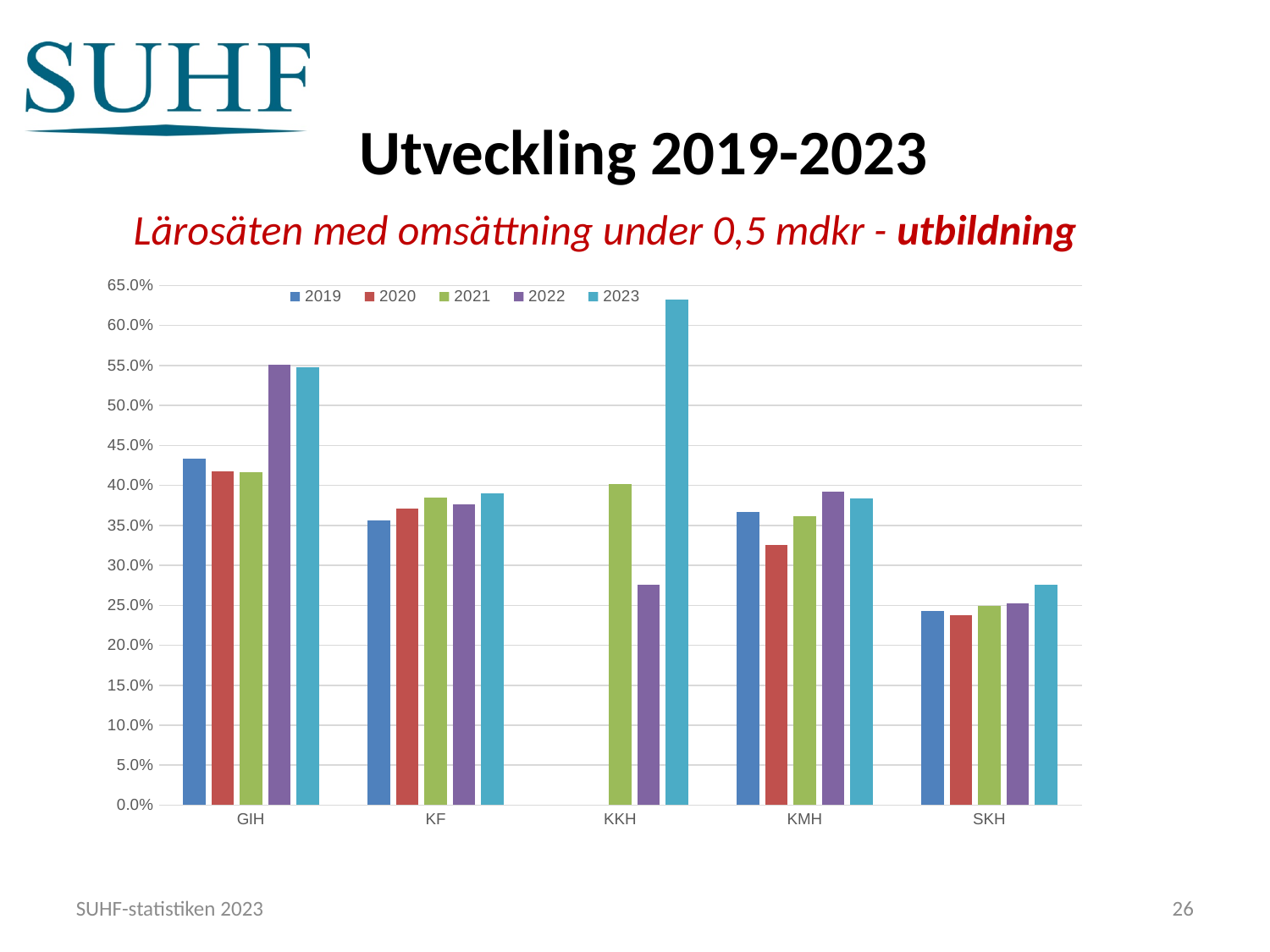
Which category has no bars for 2019 and 2020? KKH How many categories (lärosäten) are shown on the x axis? 5 Is the value for KKH in 2023 greater or less than 60%? greater Is the value for KMH in 2020 greater or less than 30%? greater Which category and year has the lowest bar in the chart? SKH, 2020 Is the value for KKH in 2022 greater or less than 30%? less What kind of chart is shown on the slide? bar chart How many series does the legend list? 5 Within KMH, which year has the lowest value? 2020 Which is larger, the 2019 value for GIH or the 2019 value for KF? GIH Which category and year has the highest bar in the chart? KKH, 2023